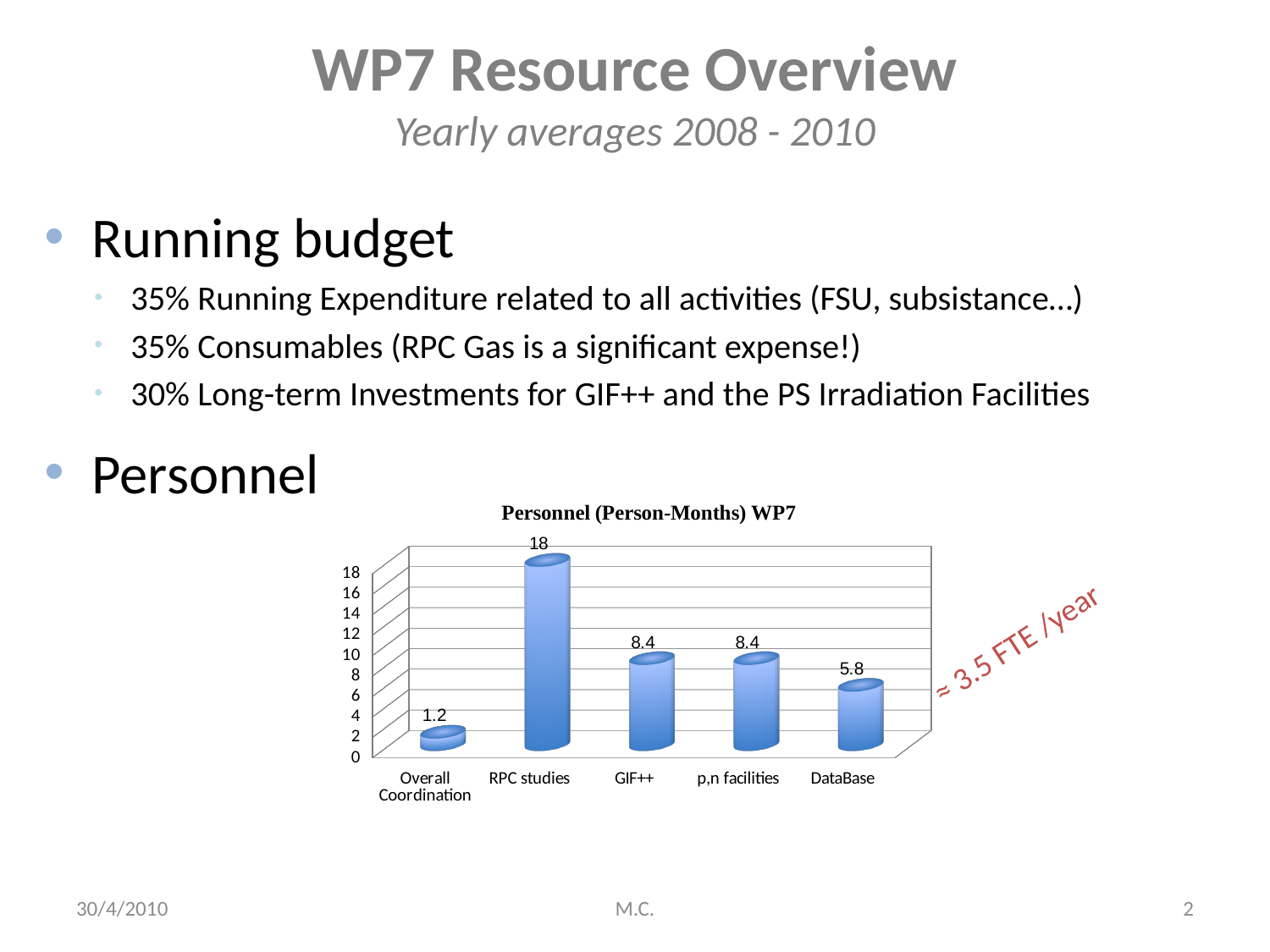
Which is larger in the Personnel (Person-Months) WP7 chart, the value for p,n facilities or the value for DataBase? p,n facilities What is the value for DataBase in the Personnel (Person-Months) WP7 chart? 5.8 How many categories are shown in the Personnel (Person-Months) WP7 chart? 5 Which category has the lowest value in the Personnel (Person-Months) WP7 chart? Overall Coordination What is the difference between the values for GIF++ and Overall Coordination in the Personnel (Person-Months) WP7 chart? 7.2 What is the value for RPC studies in the Personnel (Person-Months) WP7 chart? 18 What is the value for GIF++ in the Personnel (Person-Months) WP7 chart? 8.4 What kind of chart is the Personnel (Person-Months) WP7 chart? Bar chart Which category has the highest value in the Personnel (Person-Months) WP7 chart? RPC studies What is the value for Overall Coordination in the Personnel (Person-Months) WP7 chart? 1.2 What is the difference between the values for RPC studies and DataBase in the Personnel (Person-Months) WP7 chart? 12.2 What is the title of the chart on the slide? Personnel (Person-Months) WP7